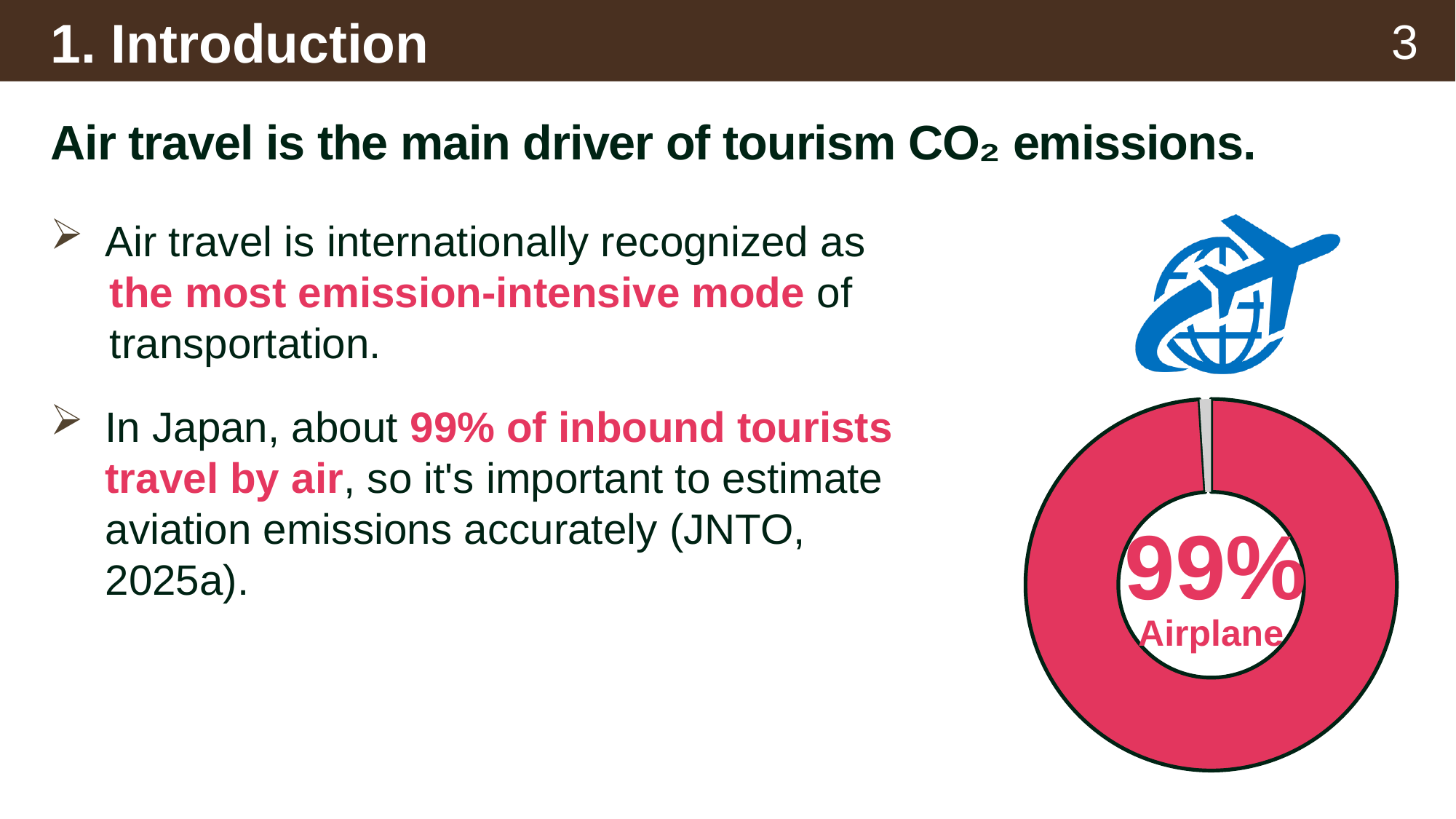
What value is printed in the centre of the donut chart? 99% What share of the pie chart does the Airplane slice represent? 99% What category label is printed inside the donut chart? Airplane Which slice of the donut chart is the largest? Airplane What colour is the Airplane slice of the donut chart? pink/red How many slices does the donut chart have? 2 What kind of chart is shown on the right of the slide? donut (pie) chart Is the Airplane slice larger or smaller than the grey slice? larger